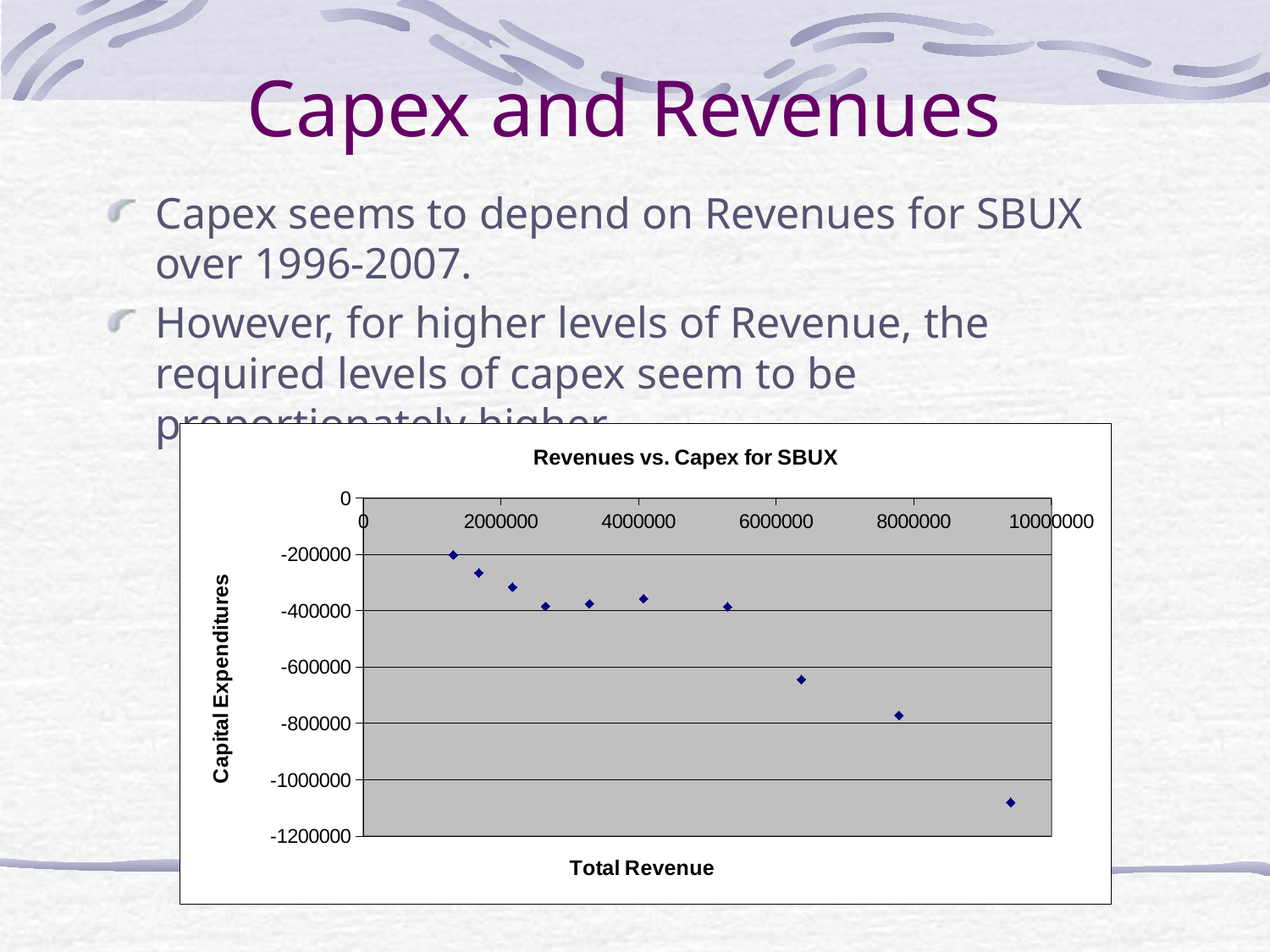
As total revenue increases along the x axis, do the capital expenditure values generally rise or fall? Fall What is the highest value shown on the horizontal axis of the chart? 10000000 Is the capital expenditure value for the point with total revenue just above 6000000 greater or less than -600000? less How many data points are plotted in the chart? 10 Does the point with the lowest (most negative) capital expenditure value have the highest or the lowest total revenue? highest Is the capital expenditure value for the point with total revenue just below 8000000 greater or less than -800000? greater Is the capital expenditure value for the point with the lowest total revenue greater or less than -400000? greater What is the title of the chart on the slide? Revenues vs. Capex for SBUX Which has the higher capital expenditure value: the point with the lowest total revenue or the point with the highest total revenue? The point with the lowest total revenue What is the label of the vertical axis of the chart? Capital Expenditures What kind of chart is shown on the slide? Scatter chart